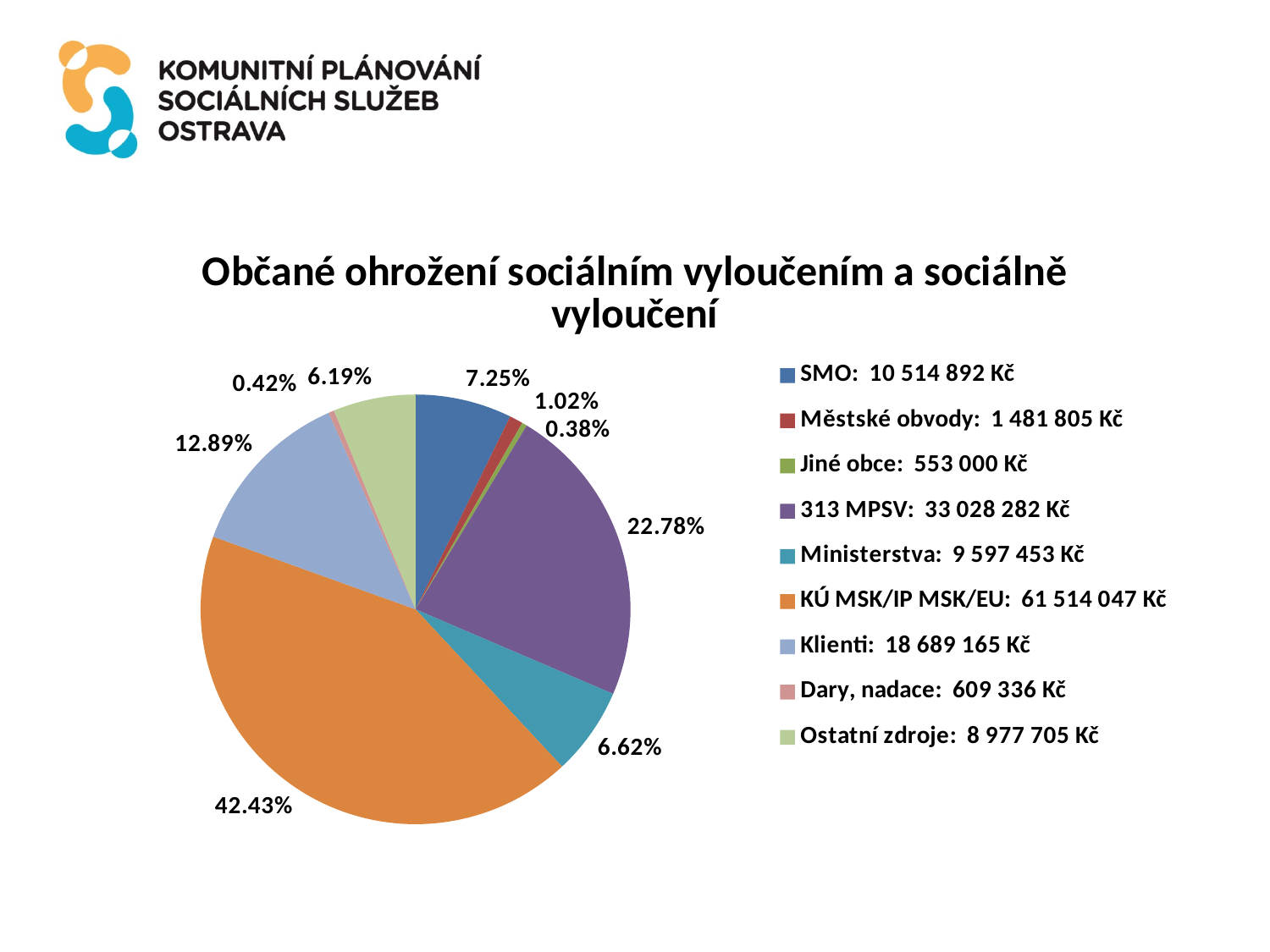
What share of the pie does Ministerstva represent? 6.62% What amount is shown in the legend for Klienti? 18 689 165 Kč What is the difference between the amounts for Městské obvody and Jiné obce? 928 805 Kč What amount is shown in the legend for 313 MPSV? 33 028 282 Kč What share of the pie does KÚ MSK/IP MSK/EU represent? 42.43% Which is larger, the amount for Ministerstva or the amount for Ostatní zdroje? Ministerstva How many slices does the pie chart have? 9 Which category has the smallest slice of the pie? Jiné obce What kind of chart is shown on the slide? pie chart What amount is shown in the legend for SMO? 10 514 892 Kč Which category has the largest slice of the pie? KÚ MSK/IP MSK/EU What is the title of the chart? Občané ohrožení sociálním vyloučením a sociálně vyloučení